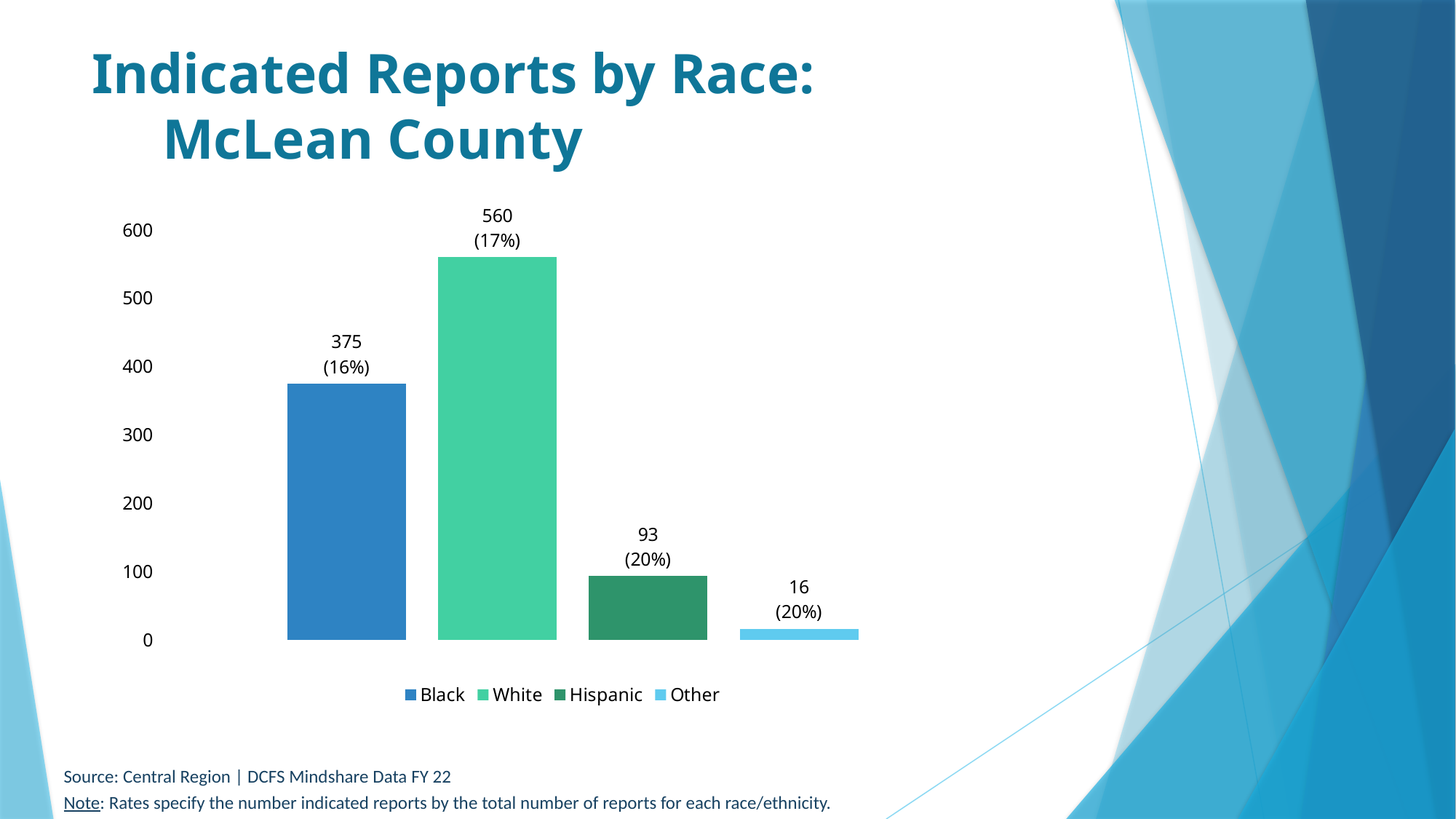
How many indicated reports are shown for White? 560 Which race/ethnicity has the highest number of indicated reports? White What rate is shown in parentheses for Hispanic? 20% What kind of chart is shown on the slide? Bar chart How many race/ethnicity categories are plotted in the chart? 4 Is the value for Black greater or less than 400? less Which race/ethnicity has the lowest number of indicated reports? Other Which has more indicated reports, Hispanic or Other? Hispanic How many indicated reports are shown for Black? 375 What is the difference between the number of indicated reports for White and for Black? 185 What is the title of the chart on the slide? Indicated Reports by Race: McLean County How many indicated reports are shown for Other? 16